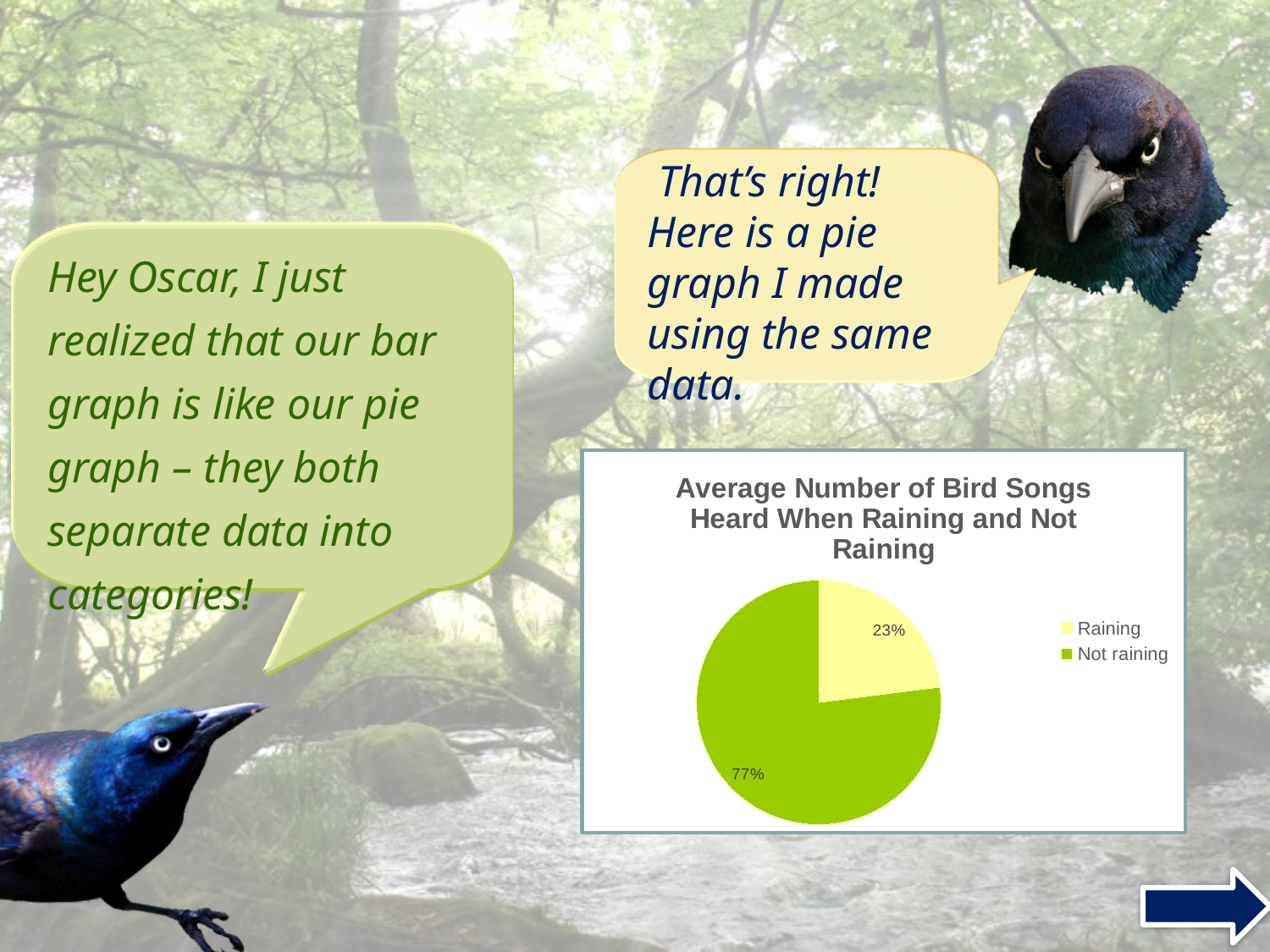
What kind of chart is shown on the slide? pie chart Which is larger, the share for Raining or the share for Not raining? Not raining Which category has the smallest share of the pie? Raining What share of the pie does the Raining slice take? 23% What percentage of the pie is labelled for Raining? 23% What percentage of the pie is labelled for Not raining? 77% What is the title of the chart? Average Number of Bird Songs Heard When Raining and Not Raining How many entries does the legend list? 2 Which legend entry is shown in the darker green colour? Not raining Which category has the largest share of the pie? Not raining What is the difference in percentage points between the Not raining share and the Raining share? 54 How many categories does the pie chart have? 2